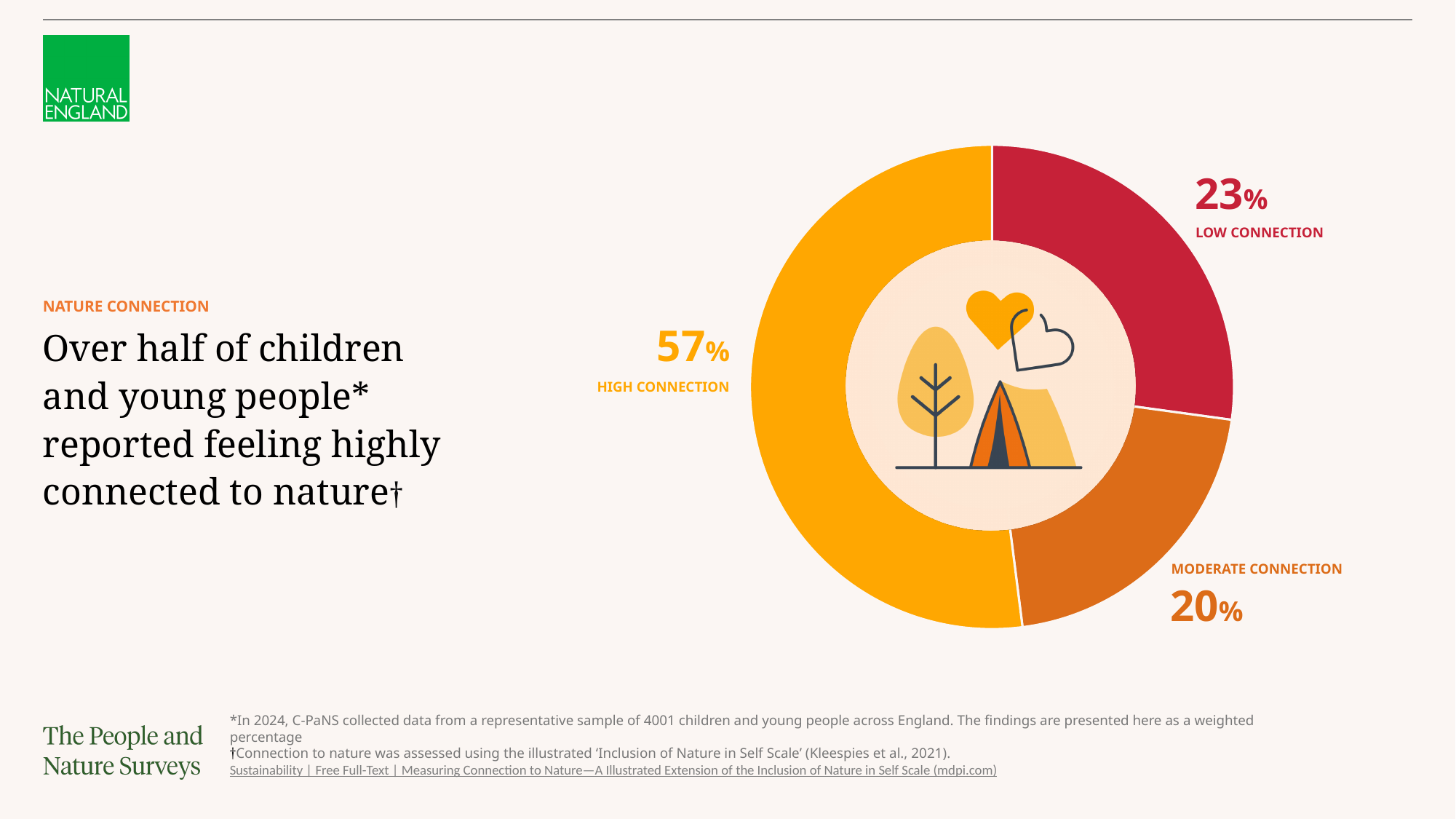
How many categories are shown in the chart? 3 What colour is the low connection segment of the chart? Red What percentage of children and young people reported a low connection to nature? 23% What percentage of children and young people reported a moderate connection to nature? 20% What is the difference in percentage points between low connection and moderate connection? 3 What is the combined share of high connection and moderate connection? 77% Which category has the largest share of the chart? High connection What is the difference in percentage points between high connection and low connection? 34 What kind of chart is shown on the slide? Pie chart (doughnut) Which is larger, the share for low connection or the share for moderate connection? Low connection Which category has the smallest share of the chart? Moderate connection What percentage of children and young people reported a high connection to nature? 57%